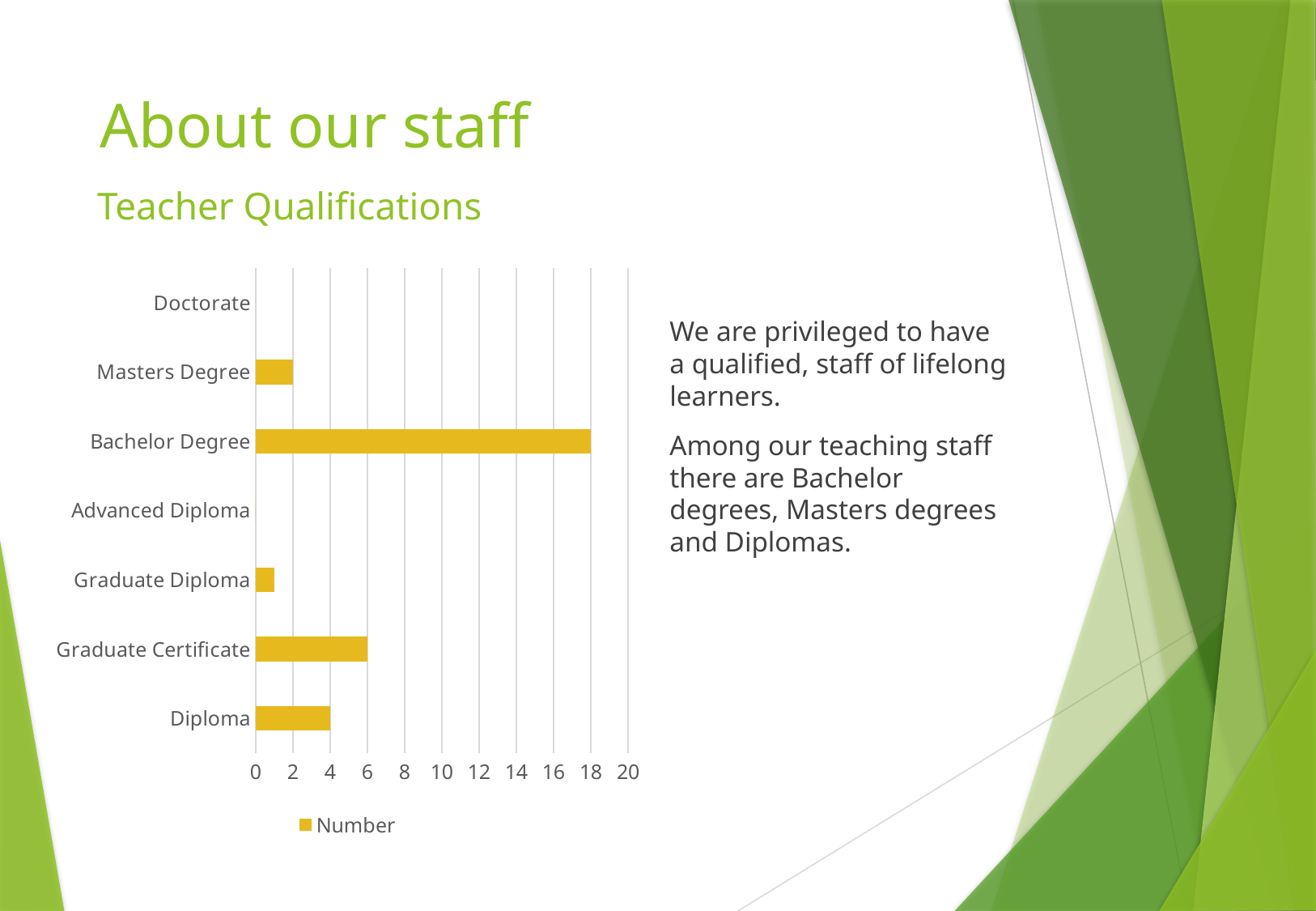
What is the difference between the values for Bachelor Degree and Graduate Certificate? 12 What kind of chart is shown on the slide? bar chart How many series does the chart's legend list? 1 Which qualification category has the highest value? Bachelor Degree What is the value for Graduate Certificate? 6 What is the value for Diploma? 4 What is the value for Bachelor Degree? 18 How many qualification categories are listed on the chart's vertical axis? 7 What is the value for Masters Degree? 2 Is the value for Graduate Diploma greater or less than 2? less Which has the larger value, Diploma or Masters Degree? Diploma What is the name of the series shown in the chart's legend? Number